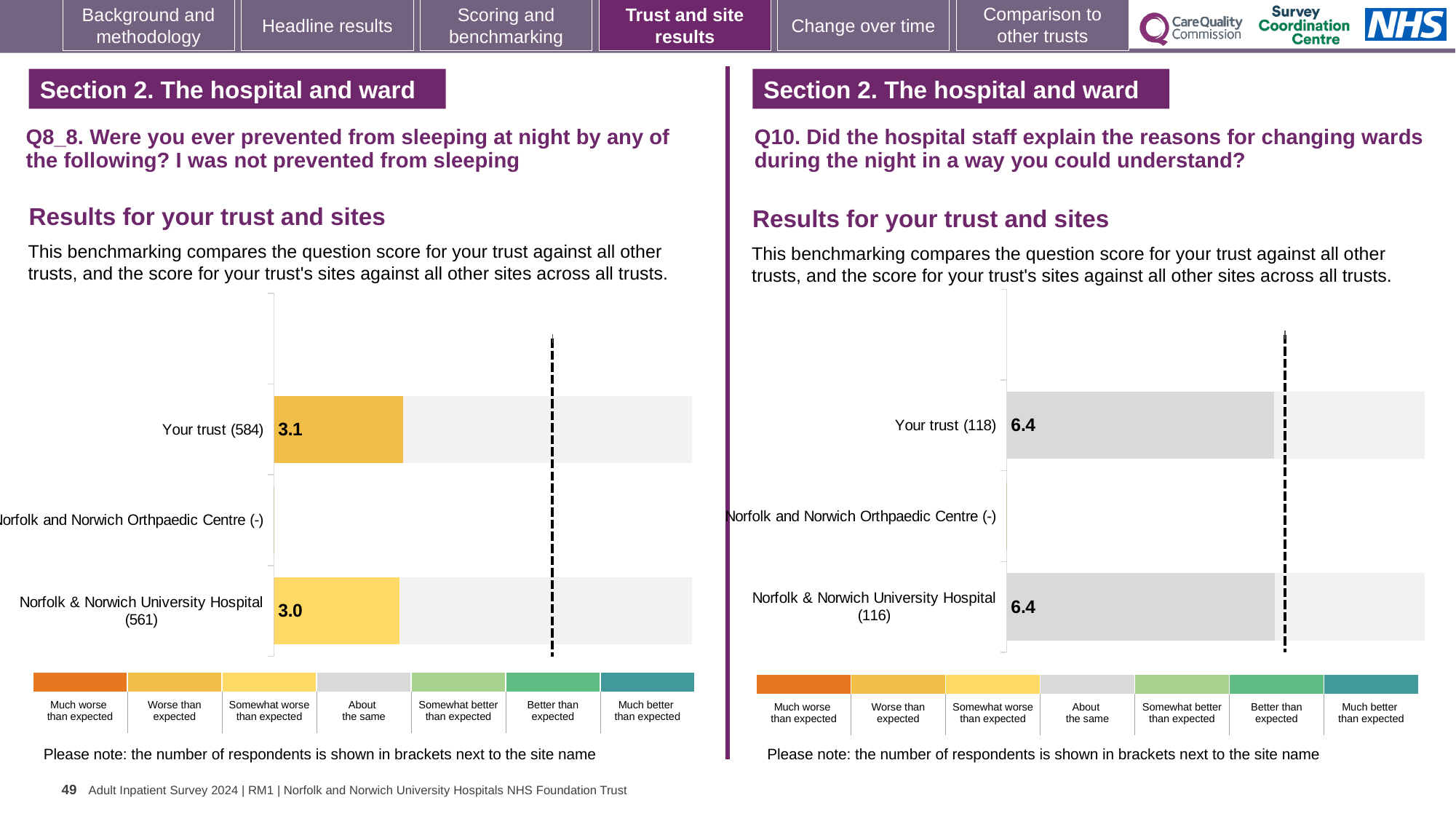
On the left chart (Q8_8), which has the higher score: Your trust (584) or Norfolk & Norwich University Hospital (561)? Your trust (584) On the right chart (Q10), what is the score for Norfolk & Norwich University Hospital (116)? 6.4 On the left chart (Q8_8), how many respondents are shown for Your trust? 584 On the left chart (Q8_8), what is the difference between the score for Your trust (584) and the score for Norfolk & Norwich University Hospital (561)? 0.1 On the left chart (Q8_8), what is the score for Norfolk & Norwich University Hospital (561)? 3.0 On the right chart (Q10), which benchmarking category does the bar colour for Your trust (118) correspond to in the legend? About the same On the left chart (Q8_8), how many site/trust categories are listed on the vertical axis? 3 On the left chart (Q8_8), which benchmarking category does the bar colour for Your trust (584) correspond to in the legend? Worse than expected On the right chart (Q10), what is the score for Your trust (118)? 6.4 On the left chart (Q8_8), what is the score for Your trust (584)? 3.1 On the right chart (Q10), what is the difference between the score for Your trust (118) and the score for Norfolk & Norwich University Hospital (116)? 0 What type of chart is used on the left (Q8_8)? Bar chart